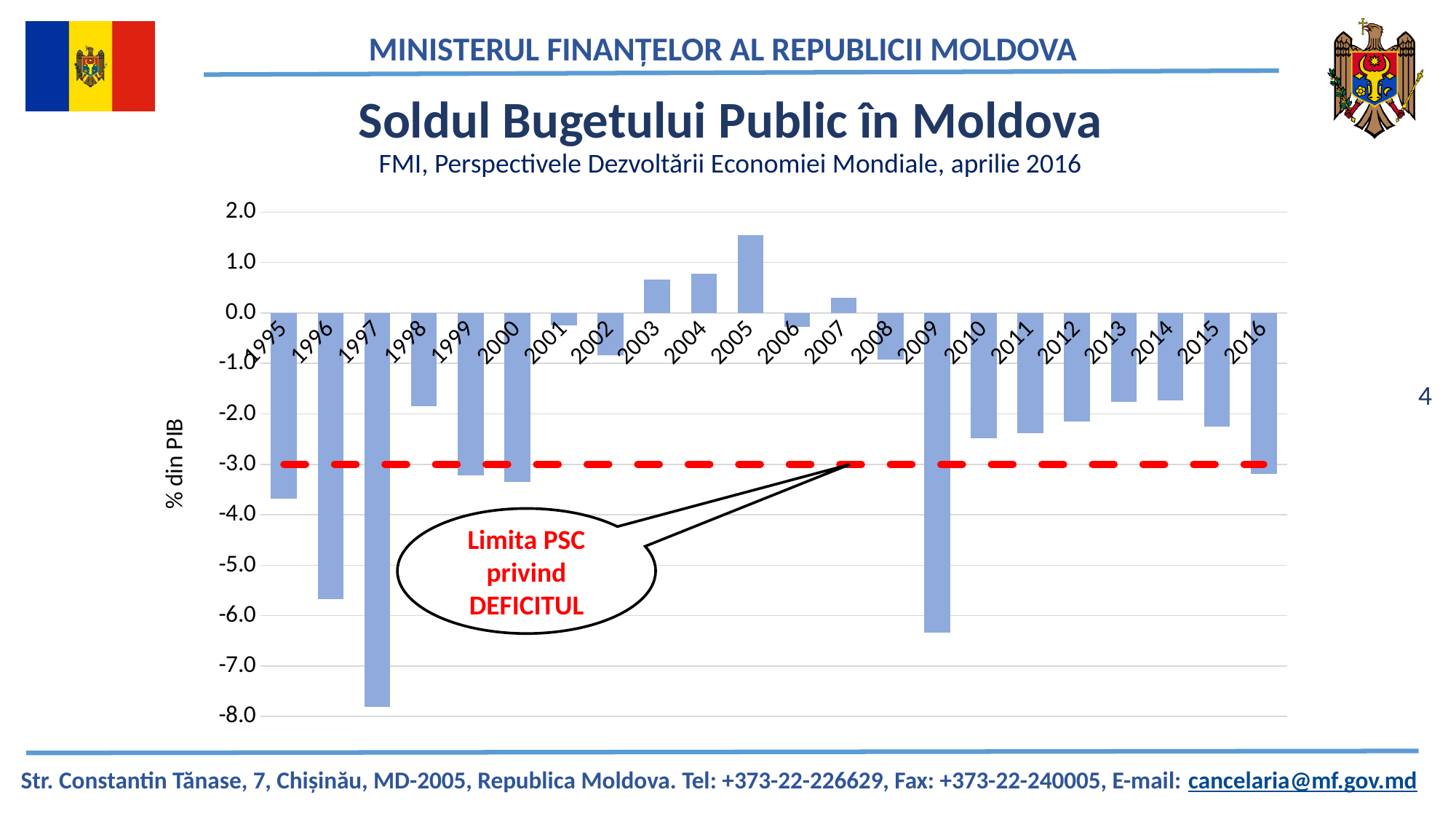
Is the value for 1996 greater or less than -5.0? less Is the value for 2009 greater or less than -6.0? less Which year has the larger budget balance, 2009 or 2010? 2010 Which year has the highest budget balance in the chart? 2005 Which year has the lowest (most negative) budget balance in the chart? 1997 Is the value for 2005 greater or less than 1.0? greater What does the red dashed line at -3.0 represent, according to the callout? Limita PSC privind DEFICITUL Which year has the larger budget balance, 1998 or 1999? 1998 What kind of chart is shown on the slide? bar chart What is the label on the vertical axis of the chart? % din PIB How many years are plotted on the x axis of the chart? 22